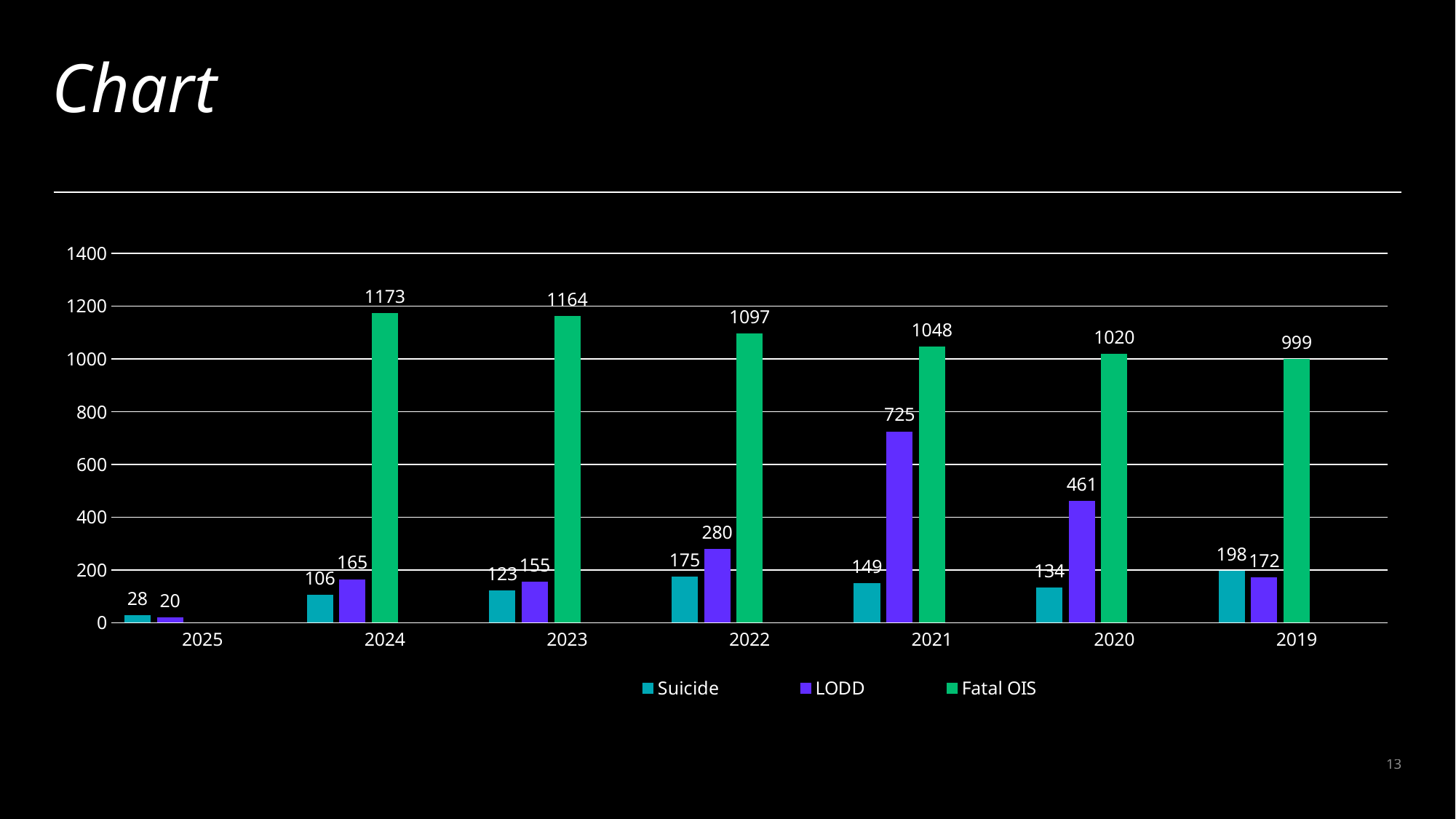
Is the Fatal OIS value for 2021 greater or less than 1000? greater What kind of chart is shown on the slide? bar chart What is the Fatal OIS value for 2024? 1173 Which is larger, the LODD value for 2020 or the LODD value for 2022? LODD value for 2020 Which year has the highest Fatal OIS value? 2024 What is the difference between the Fatal OIS values for 2024 and 2019? 174 What is the Suicide value for 2019? 198 What is the LODD value for 2021? 725 How many years are shown on the x axis? 7 How many series does the legend list? 3 What is the title of the slide? Chart Which year has the lowest Suicide value? 2025